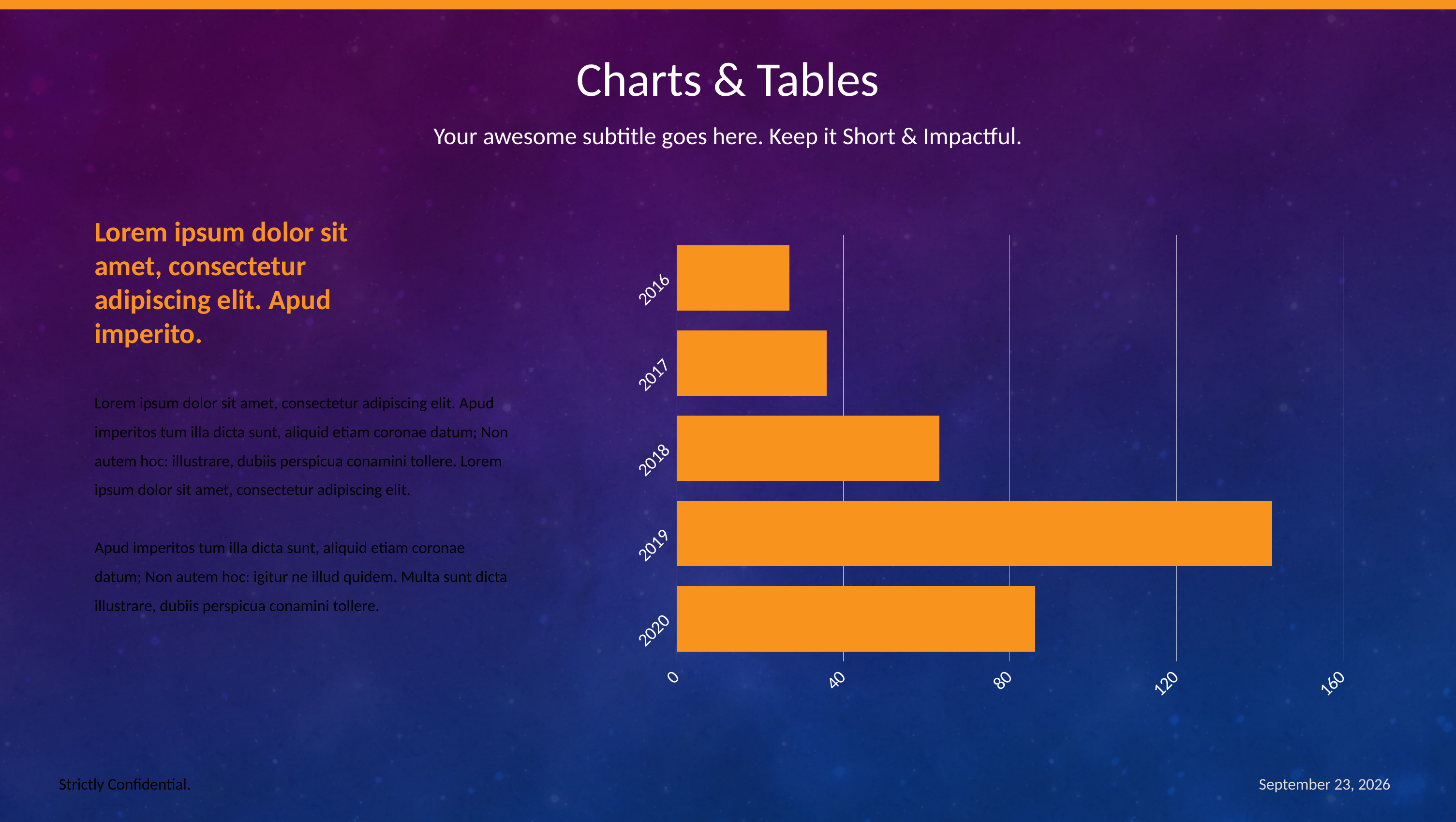
Is the value for 2019 greater or less than 120? greater Which has the larger value, 2016 or 2017? 2017 Which has the larger value, 2018 or 2020? 2020 How many years are shown on the chart? 5 Which year has the highest value? 2019 What colour are the bars in the chart? orange Which year has the lowest value? 2016 Is the value for 2018 greater or less than 80? less What kind of chart is shown on the slide? bar chart Is the value for 2016 greater or less than 40? less Do the values rise or fall from 2016 to 2019? rise